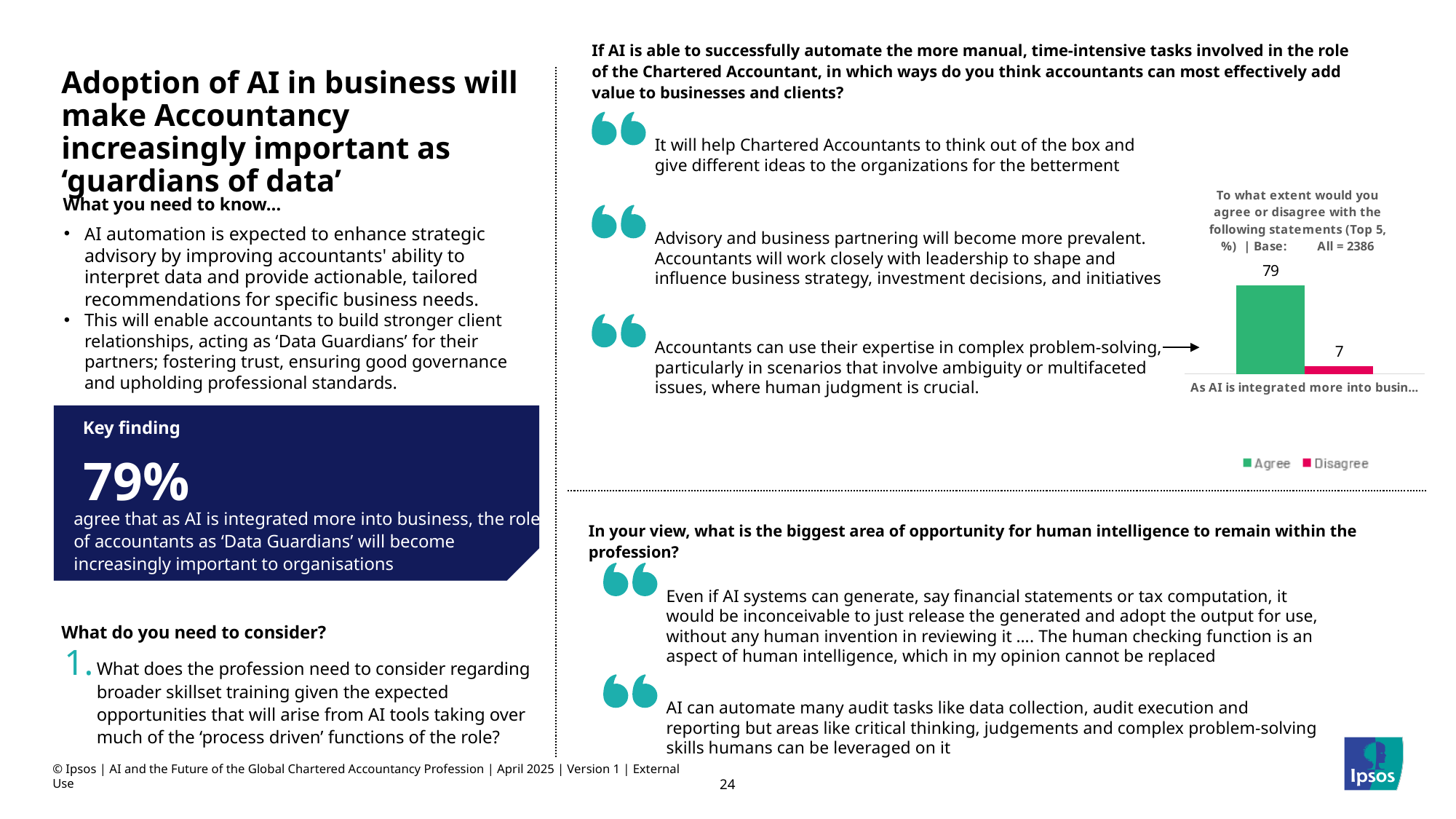
What is the value for Disagree in the bar chart? 7 How many bars are plotted in the chart? 2 How many series does the legend of the bar chart list? 2 What is the value for Agree in the bar chart? 79 What base size is stated in the chart title? All = 2386 What colour is the Agree bar in the chart? Green Which series has the higher value in the bar chart, Agree or Disagree? Agree What is the difference between the Agree and Disagree values in the bar chart? 72 What kind of chart is shown on the slide? Bar chart Which series has the lowest value in the bar chart? Disagree